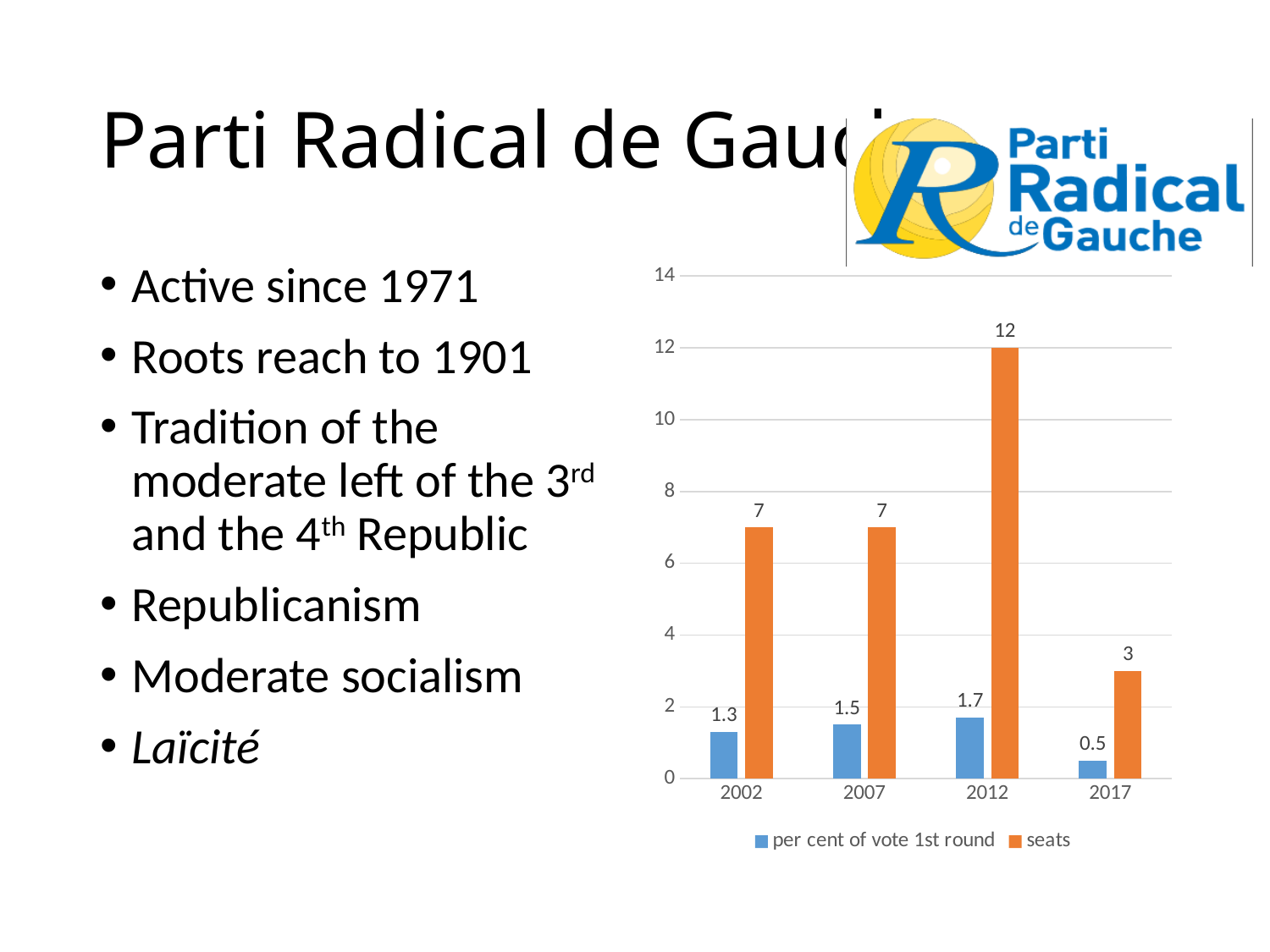
Which year had a higher per cent of vote in the 1st round, 2002 or 2012? 2012 Which colour represents the seats series? orange What is the number of seats in 2012? 12 What is the per cent of vote in the 1st round in 2007? 1.5 In which year was the per cent of vote in the 1st round lowest? 2017 How many years are shown on the x axis? 4 What is the difference in seats between 2012 and 2017? 9 What kind of chart is shown on the slide? bar chart What is the per cent of vote in the 1st round in 2017? 0.5 In which year was the number of seats highest? 2012 How many series does the legend list? 2 Is the number of seats in 2007 greater or less than 6? greater